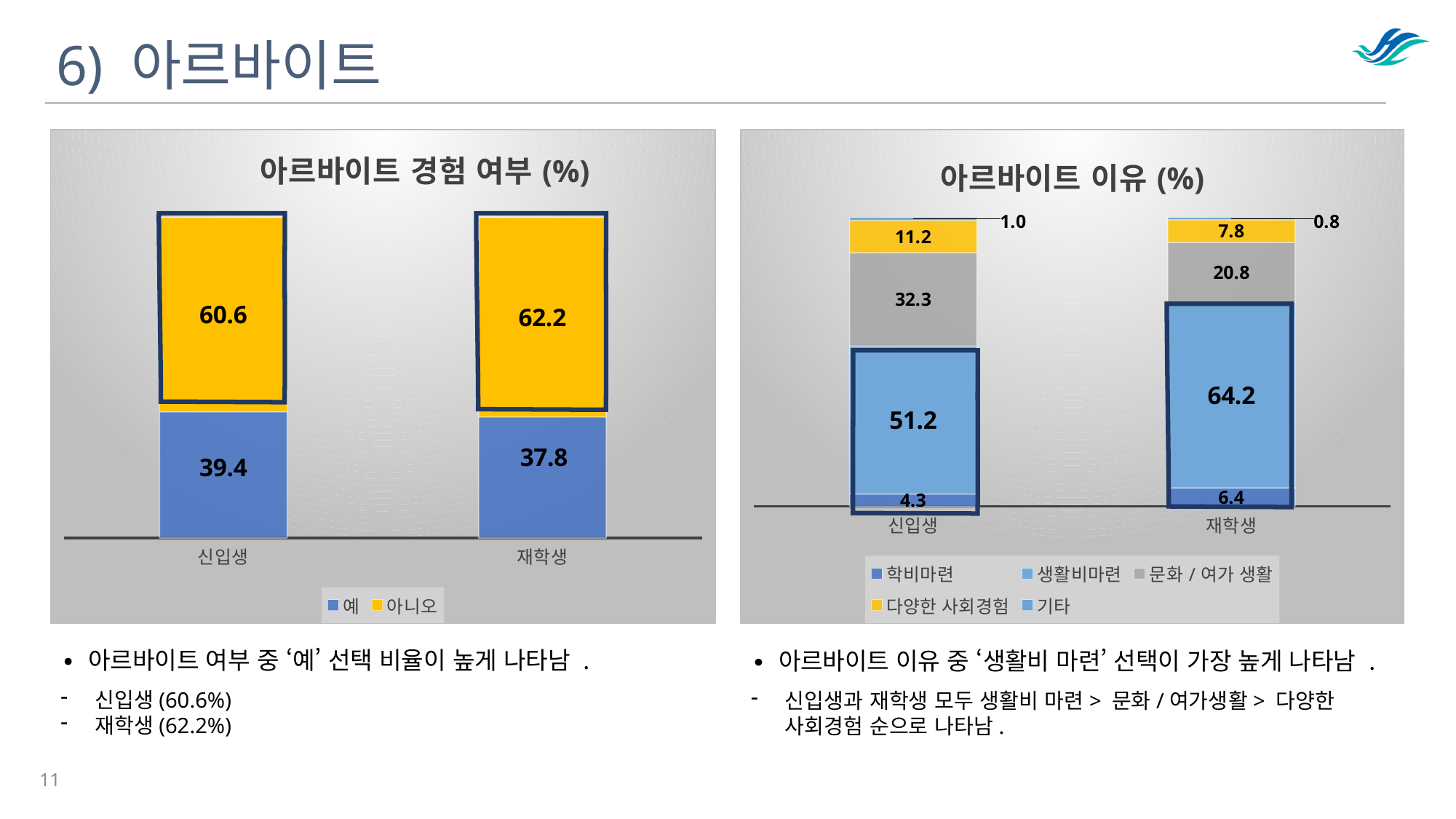
In the chart titled '아르바이트 경험 여부 (%)', what is the value of '아니오' for 재학생? 62.2 In the chart titled '아르바이트 경험 여부 (%)', which category has the larger '예' value, 신입생 or 재학생? 신입생 What kind of chart is the chart titled '아르바이트 이유 (%)'? Stacked bar chart In the chart titled '아르바이트 이유 (%)', what is the value of '생활비마련' for 재학생? 64.2 In the chart titled '아르바이트 경험 여부 (%)', what is the difference between the '아니오' values for 재학생 and 신입생? 1.6 In the chart titled '아르바이트 이유 (%)', how many series does the legend list? 5 In the chart titled '아르바이트 이유 (%)', what is the difference between the '생활비마련' values for 재학생 and 신입생? 13.0 In the chart titled '아르바이트 경험 여부 (%)', what is the value of '예' for 신입생? 39.4 In the chart titled '아르바이트 이유 (%)', what is the value of '기타' for 재학생? 0.8 In the chart titled '아르바이트 이유 (%)', which series has the highest value for 신입생? 생활비마련 In the chart titled '아르바이트 이유 (%)', what is the value of '문화 / 여가 생활' for 신입생? 32.3 In the chart titled '아르바이트 경험 여부 (%)', how many series does the legend list? 2